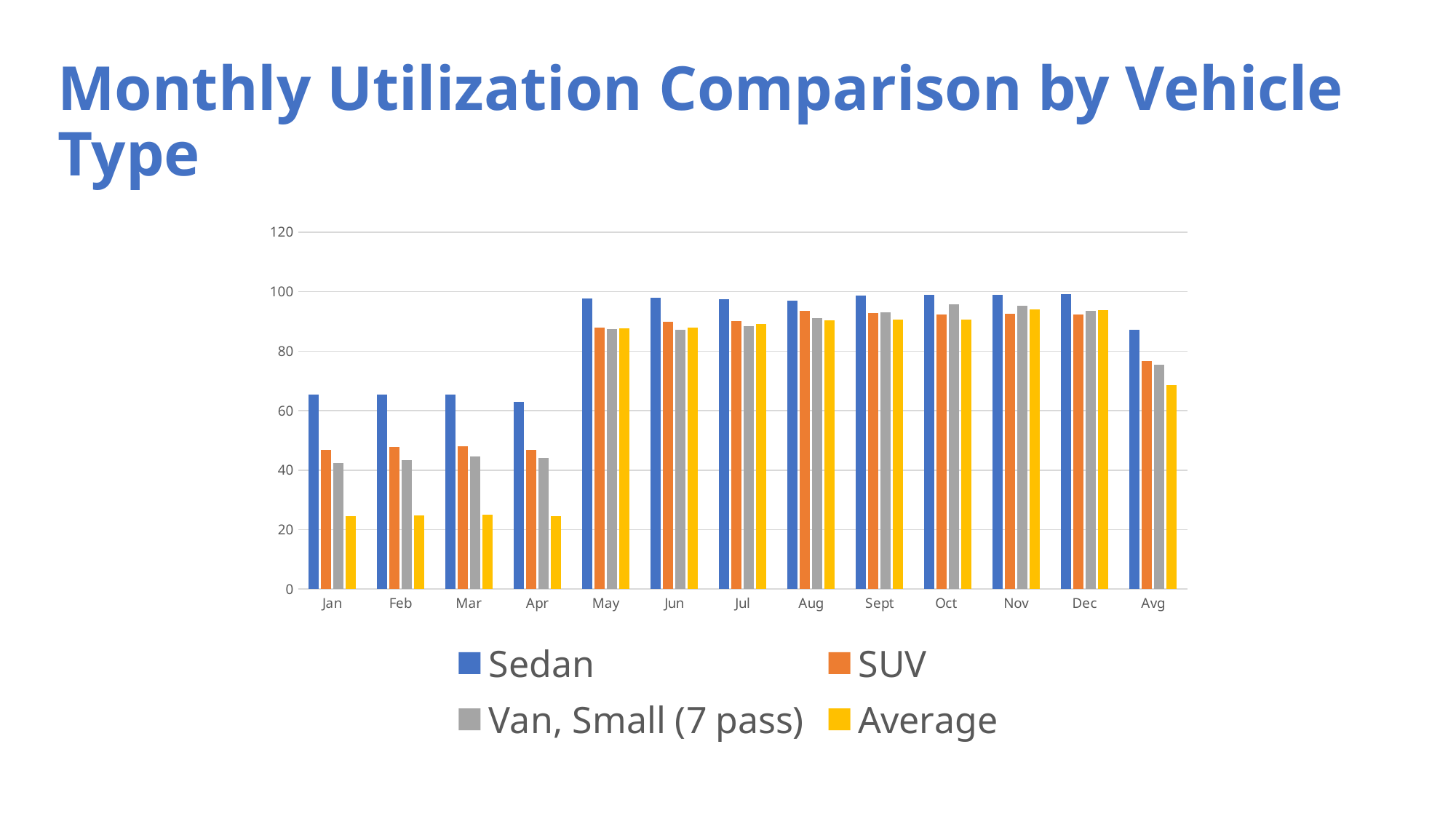
How many series does the legend list? 4 Does the Average series rise or fall from Apr to May? rise Which series has the highest bar in Jan? Sedan Is the value for SUV in Mar greater or less than 60? less What kind of chart is shown on the slide? bar chart Is the value for Sedan in May greater or less than 100? less What is the title of the chart? Monthly Utilization Comparison by Vehicle Type Which is larger in Apr, the Sedan value or the SUV value? Sedan Which series has the lowest bar in Jan? Average Is the value for Average in Feb greater or less than 40? less How many categories are shown along the x axis? 13